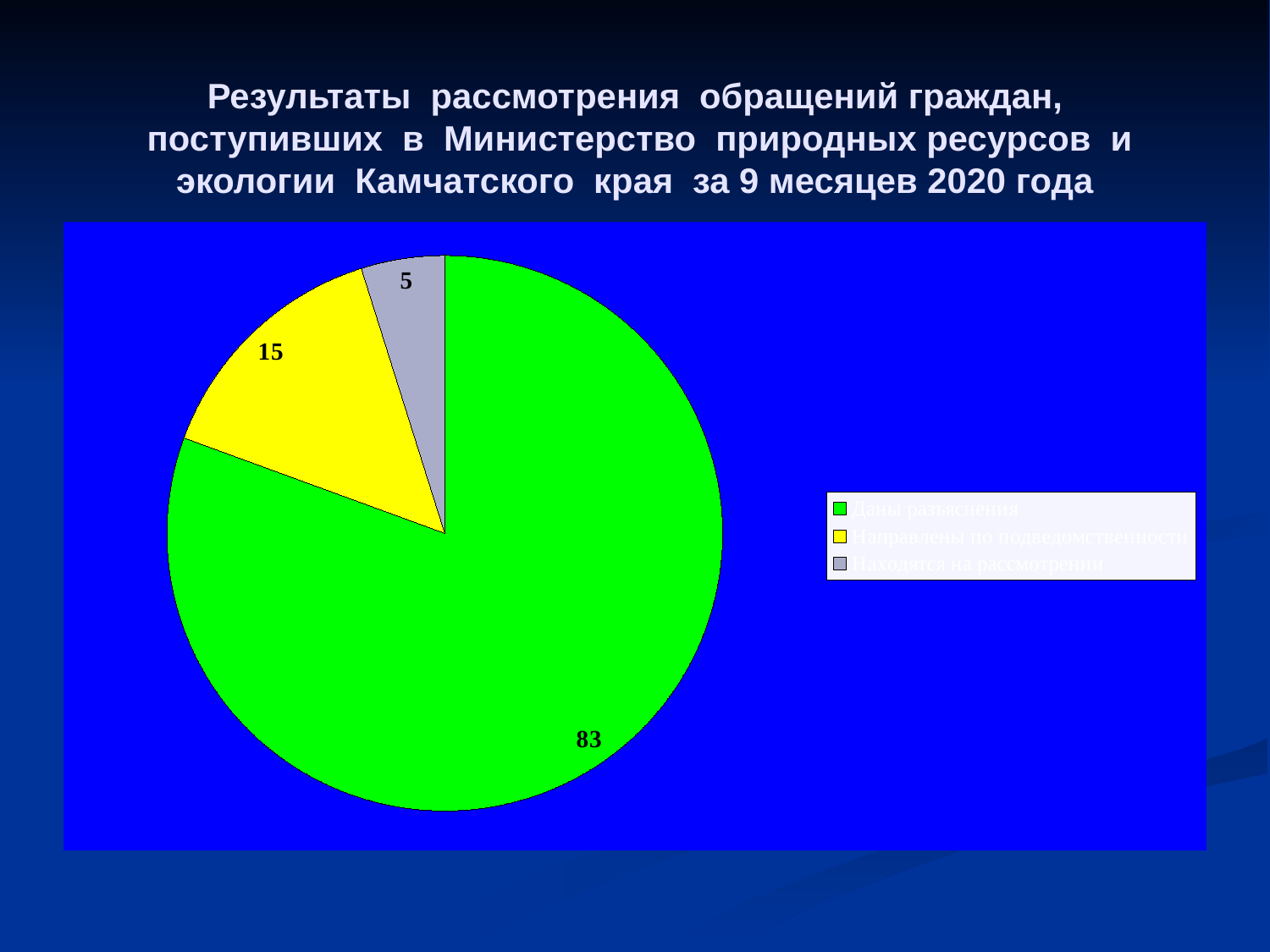
What is the total of all three slice values? 103 Which colour represents 'Находятся на рассмотрении' in the legend? grey What is the difference between the green slice (83) and the yellow slice (15)? 68 What kind of chart is shown on the slide? pie chart Which category has the largest slice of the pie? Даны разъяснения Which is larger, the yellow slice or the grey slice? the yellow slice How many slices does the pie chart have? 3 What is the value of the green slice (Даны разъяснения)? 83 How many entries does the legend list? 3 Which category has the smallest slice of the pie? Находятся на рассмотрении What is the value of the grey slice (Находятся на рассмотрении)? 5 What is the value of the yellow slice (Направлены по подведомственности)? 15